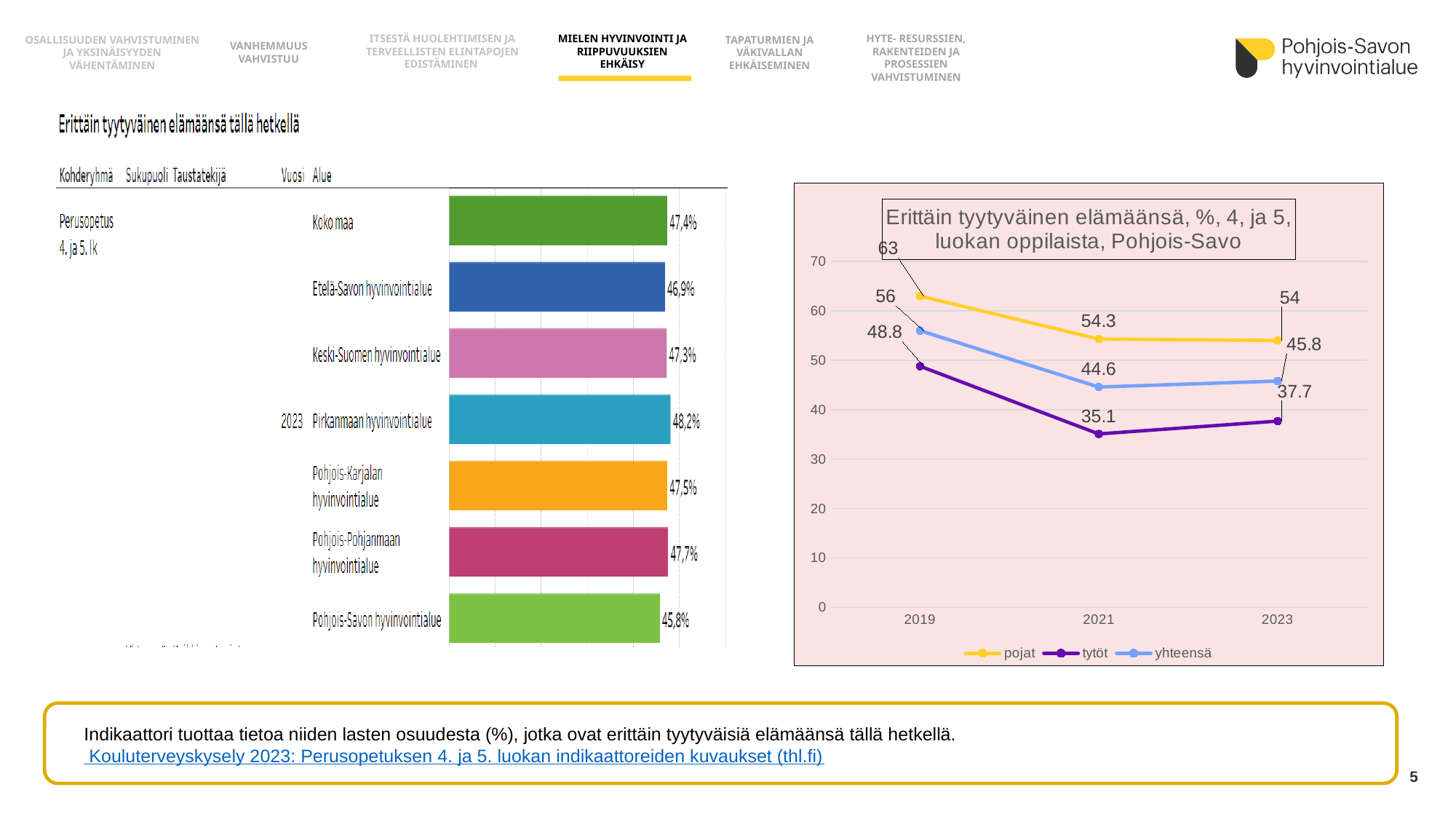
In the right line chart, how many series does the legend list? 3 In the left bar chart, how many regions are shown? 7 In the left bar chart, which region has the lowest value? Pohjois-Savon hyvinvointialue In the right line chart, which is larger in 2021: pojat or yhteensä? pojat In the left bar chart, what is the value for Pirkanmaan hyvinvointialue? 48,2% In the left bar chart, which region has the highest value? Pirkanmaan hyvinvointialue What kind of chart is the chart on the left side of the slide? Bar chart In the right line chart, what is the value for pojat in 2019? 63 In the right line chart, what is the value for tytöt in 2021? 35.1 In the right line chart, what is the difference between pojat and tytöt in 2023? 16.3 In the left bar chart, what is the value for Pohjois-Savon hyvinvointialue? 45,8% In the right line chart, does the value for yhteensä rise or fall from 2019 to 2021? Fall